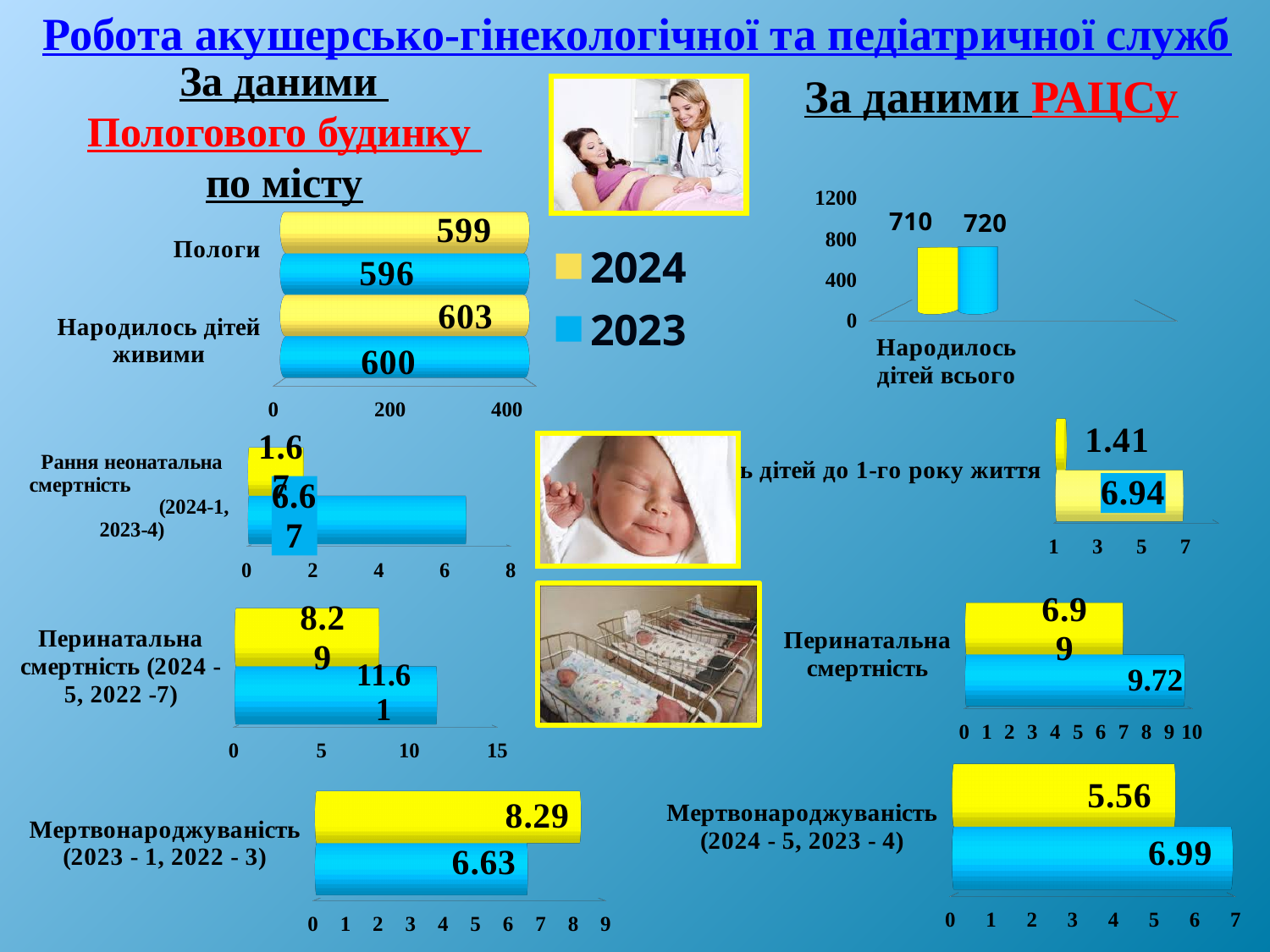
In the chart titled Мертвонароджуваність (2024 - 5, 2023 - 4) on the right, what is the difference between the blue bar and the yellow bar? 1.43 In the chart titled Народилось дітей всього (За даними РАЦСу), which bar is larger, the yellow one or the blue one? the blue one In the top-left chart (За даними Пологового будинку по місту), what is the value of the 2024 (yellow) bar for Пологи? 599 In the top-left chart (За даними Пологового будинку по місту), what is the value of the 2023 (blue) bar for Народилось дітей живими? 600 How many series does the legend next to the top-left chart list? 2 In the chart titled Народилось дітей всього (За даними РАЦСу), is the value of the yellow bar greater or less than 800? less In the chart titled Мертвонароджуваність (2023 - 1, 2022 - 3) on the left, what is the value of the yellow bar? 8.29 In the chart titled Перинатальна смертність (2024 - 5, 2022 - 7) on the left, what is the value of the blue bar? 11.61 In the chart titled Перинатальна смертність on the right (За даними РАЦСу), what is the value of the blue bar? 9.72 What type of chart is the Народилось дітей всього chart on the right? bar chart In the top-left chart (За даними Пологового будинку по місту), what is the difference between the 2024 and 2023 values for Пологи? 3 In the chart titled Народилось дітей всього (За даними РАЦСу), what is the value of the blue bar? 720